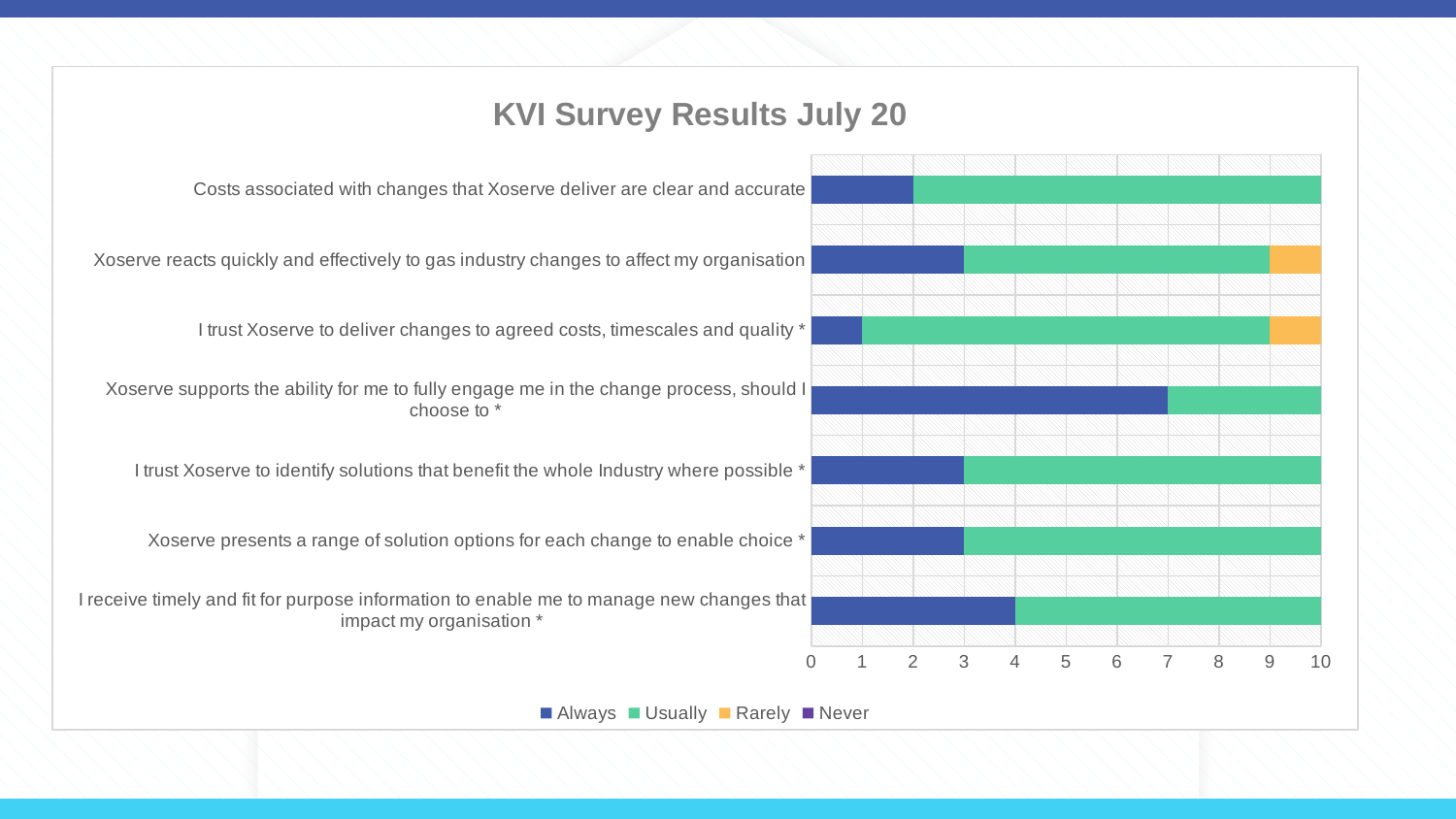
What is the title of the chart? KVI Survey Results July 20 What is the 'Always' value for 'I receive timely and fit for purpose information to enable me to manage new changes that impact my organisation *'? 4 What is the difference between the 'Always' values for 'Xoserve supports the ability for me to fully engage me in the change process...' and 'Costs associated with changes that Xoserve deliver are clear and accurate'? 5 Which statement has the highest 'Always' value? Xoserve supports the ability for me to fully engage me in the change process, should I choose to * How many survey statements (categories) are plotted on the chart? 7 How many series does the legend list? 4 What is the 'Always' value for 'Costs associated with changes that Xoserve deliver are clear and accurate'? 2 What is the 'Always' value for 'Xoserve supports the ability for me to fully engage me in the change process, should I choose to *'? 7 What kind of chart is shown on the slide? Stacked bar chart What is the total of the stacked bar for 'Costs associated with changes that Xoserve deliver are clear and accurate'? 10 Which has the larger 'Always' value: 'I receive timely and fit for purpose information...' or 'Costs associated with changes that Xoserve deliver are clear and accurate'? I receive timely and fit for purpose information to enable me to manage new changes that impact my organisation * Which statement has the lowest 'Always' value? I trust Xoserve to deliver changes to agreed costs, timescales and quality *